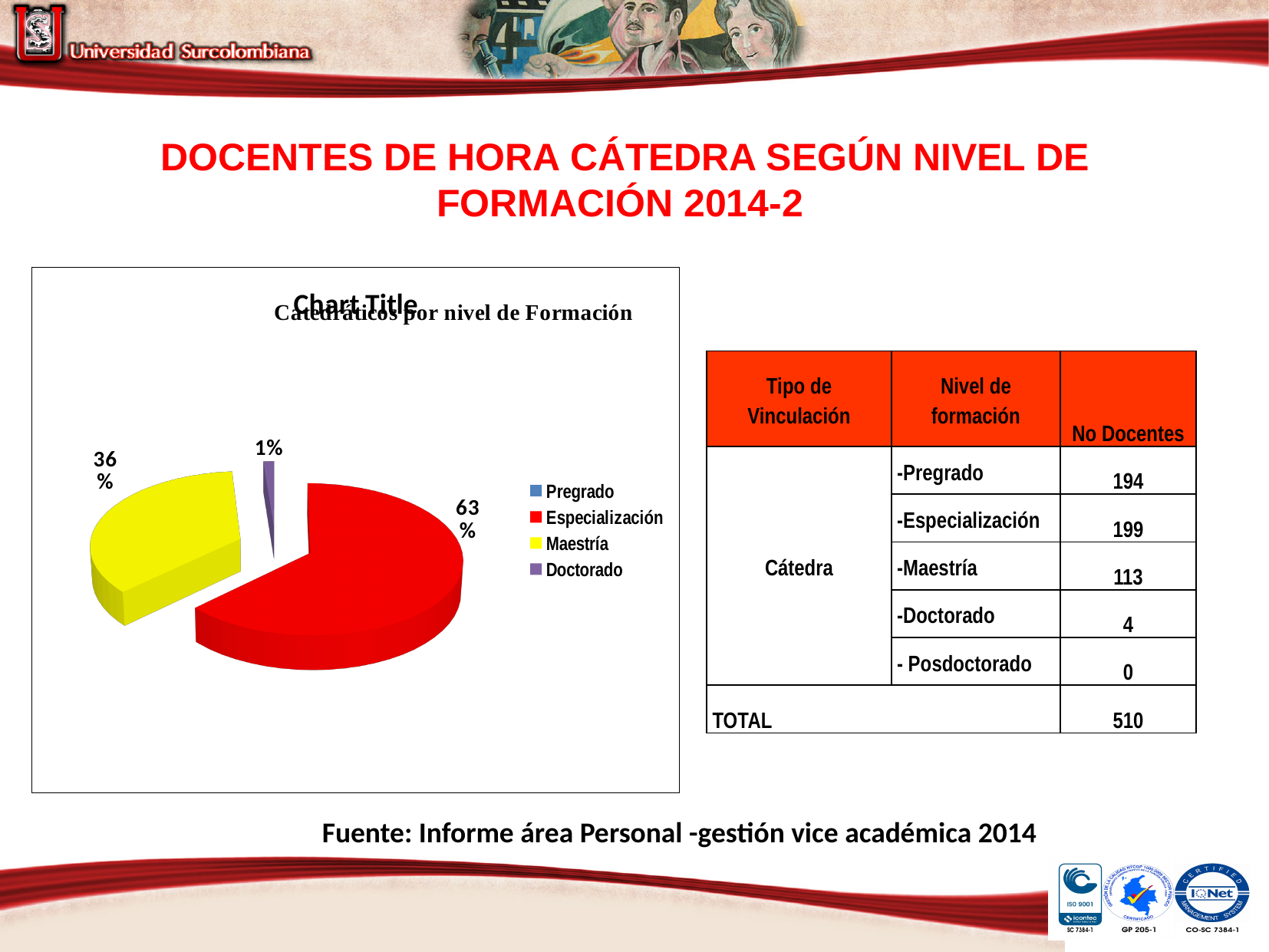
Which category has the largest slice in the pie chart? Especialización How many entries does the legend of the pie chart list? 4 What percentage of the pie chart corresponds to Maestría? 36% What colour is the Maestría slice in the pie chart? yellow By how many percentage points does the Especialización slice exceed the Maestría slice? 27 What percentage of the pie chart corresponds to Especialización? 63% Which labelled category has the smallest slice in the pie chart? Doctorado What percentage of the pie chart corresponds to Doctorado? 1% What colour represents Especialización in the pie chart legend? red Which slice is larger in the pie chart, Especialización or Maestría? Especialización What kind of chart is shown on the slide? pie chart Is the share for Especialización in the pie chart greater or less than 50%? greater